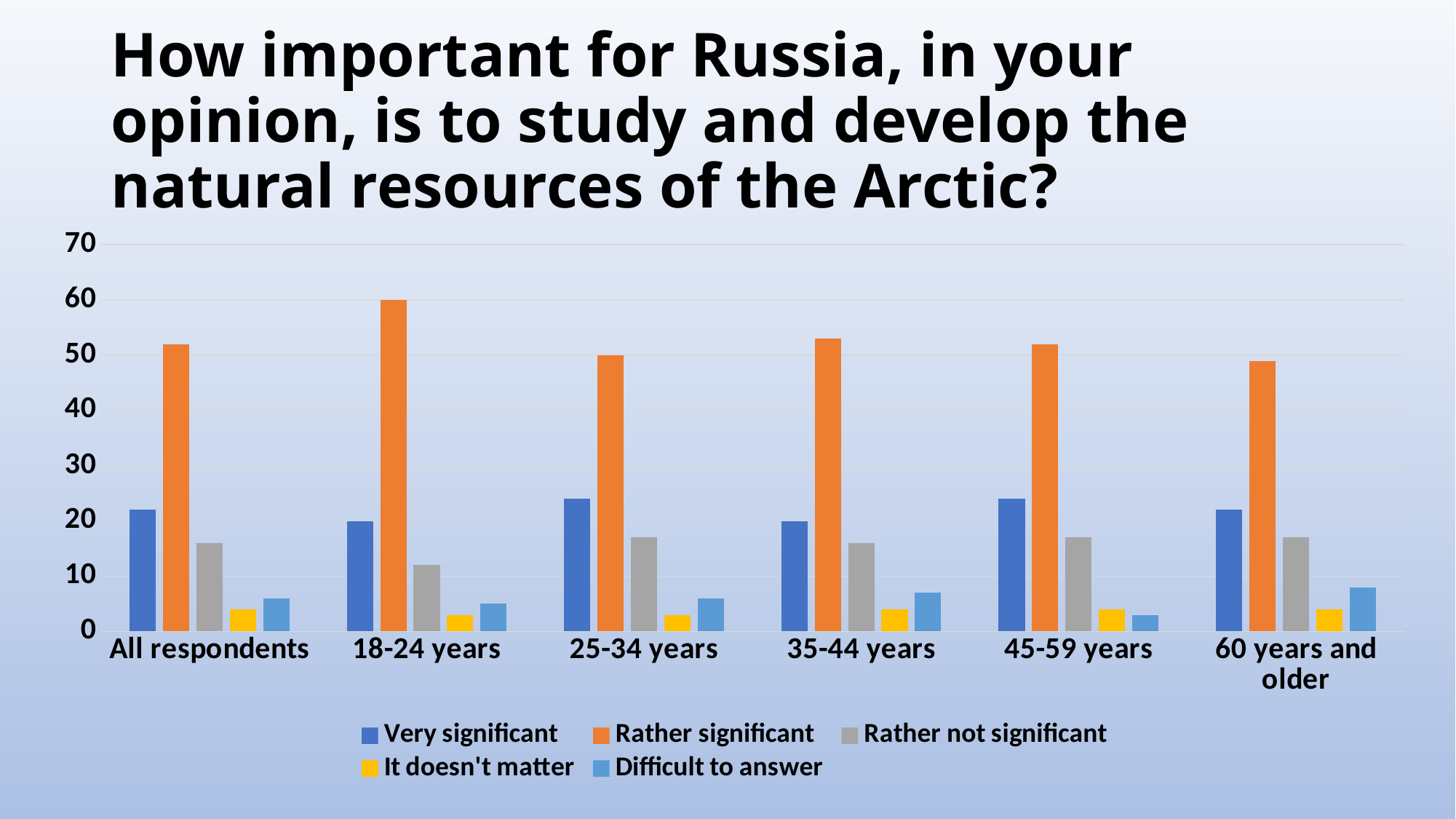
Which category has the lowest 'Rather significant' value? 60 years and older Is the value for 'Very significant' for All respondents greater or less than 30? less How many series does the legend list? 5 What is the value of 'Rather significant' for 25-34 years? 50 Is the value for 'Rather significant' for 35-44 years greater or less than 50? greater What is the value of 'Rather significant' for 18-24 years? 60 Which is larger for 18-24 years: 'Very significant' or 'Rather not significant'? Very significant What kind of chart is shown on the slide? bar chart How many categories are shown along the x axis? 6 Which category has the highest 'Rather significant' value? 18-24 years Which series is shown in orange in the legend? Rather significant